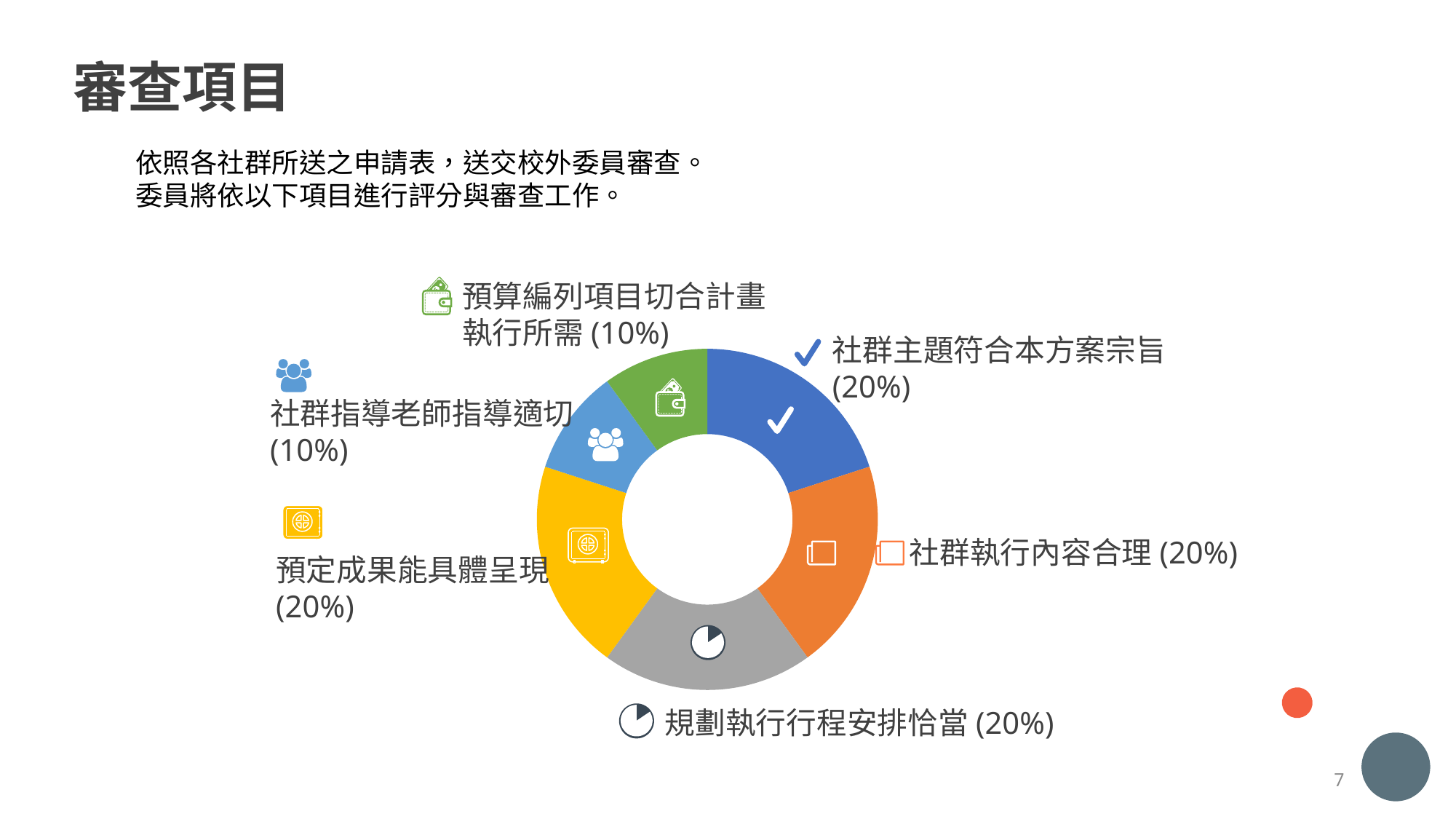
What colour is the slice for 規劃執行行程安排恰當? Grey Which is larger, the share for 社群執行內容合理 or the share for 社群指導老師指導適切? 社群執行內容合理 What percentage is shown for 預算編列項目切合計畫執行所需? 10% How many categories does the chart show? 6 What percentage is shown for 社群主題符合本方案宗旨? 20% What is the combined share of the four categories that each have 20%? 80% What is the difference between the share for 預定成果能具體呈現 and the share for 預算編列項目切合計畫執行所需? 10% What kind of chart is shown on the slide? Doughnut (pie) chart What percentage is shown for 社群指導老師指導適切? 10% Which two categories have the smallest share in the chart? 社群指導老師指導適切 and 預算編列項目切合計畫執行所需 What percentage is shown for 規劃執行行程安排恰當? 20% What percentage is shown for 預定成果能具體呈現? 20%